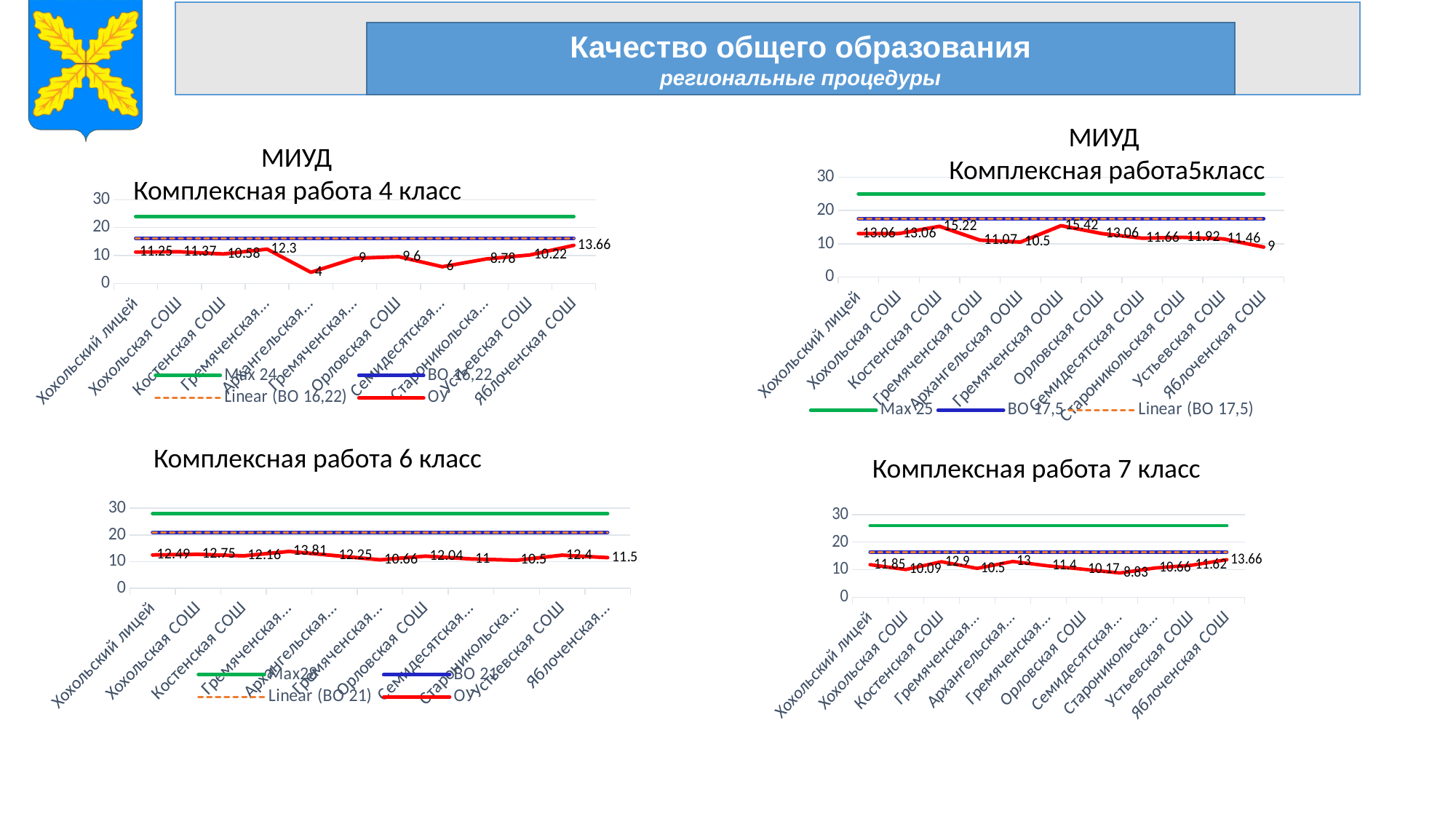
In the chart 'Комплексная работа5класс', which school has the highest value on the red line? Гремяченская ООШ How many schools are plotted along the x axis of the chart 'Комплексная работа 7 класс'? 11 In the chart 'Комплексная работа 7 класс', which is larger: the value for Хохольский лицей or the value for Хохольская СОШ? Хохольский лицей In the chart 'Комплексная работа 4 класс', what is the value for Яблоченская СОШ? 13.66 In the chart 'Комплексная работа 6 класс', what is the value for Орловская СОШ? 12.04 In the chart 'Комплексная работа 6 класс', which school has the highest value on the red line? Гремяченская... In the chart 'Комплексная работа 4 класс', what is the difference between the values for Хохольская СОШ and Хохольский лицей? 0.12 What type of chart is 'Комплексная работа 6 класс'? Line chart In the chart 'Комплексная работа 7 класс', what is the value for Семидесятская...? 8.83 In the chart 'Комплексная работа 4 класс', which school has the lowest value on the red line? Архангельская... In the chart 'Комплексная работа5класс', what is the value for Яблоченская СОШ? 9 In the chart 'Комплексная работа5класс', what is the value for Костенская СОШ? 15.22